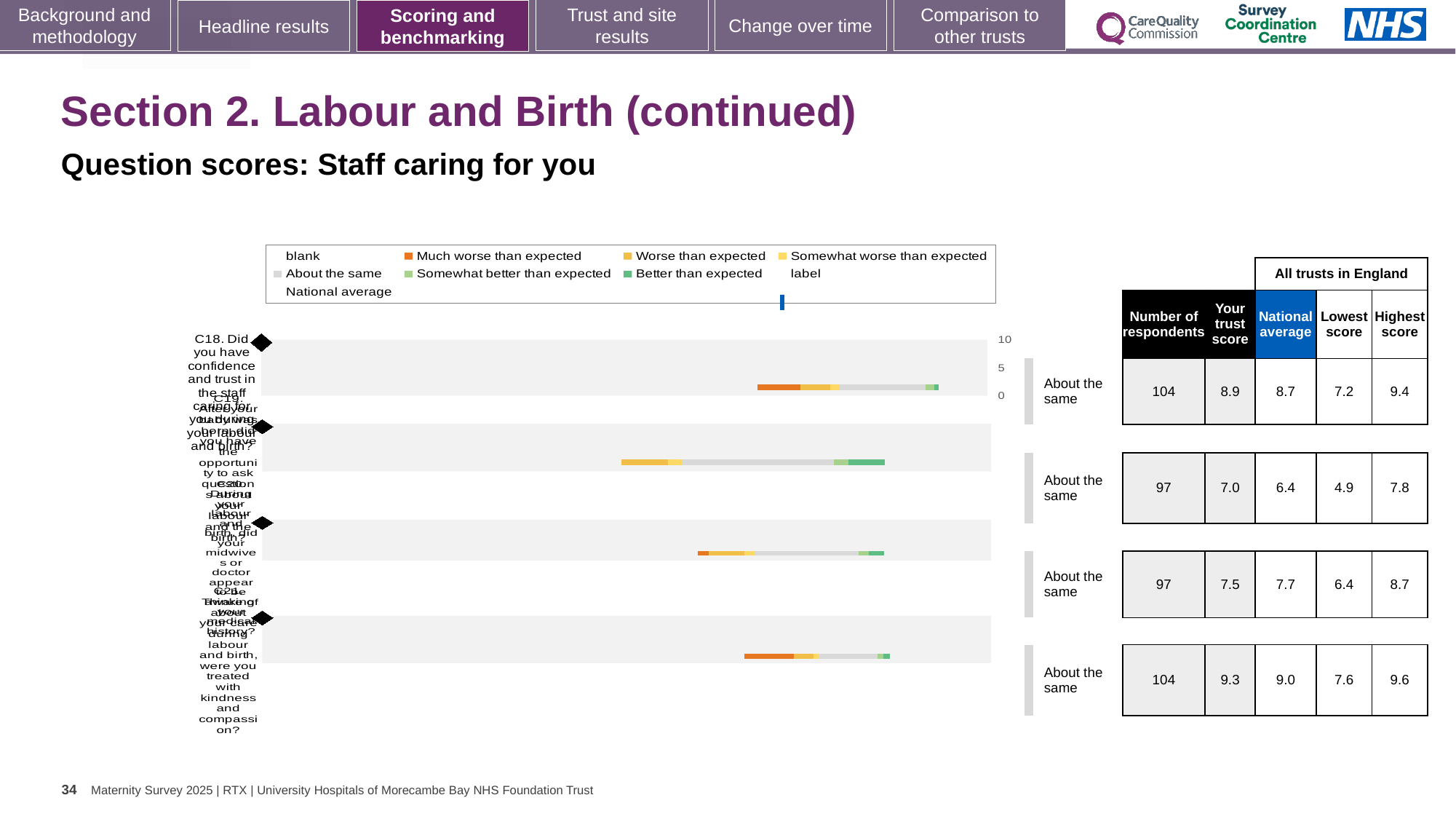
Which row in the table has the highest 'Your trust score'? the fourth row (9.3) In the table beside the chart, what is the number of respondents for the first row (C18)? 104 For the last row (C21), what is the difference between the trust score and the national average? 0.3 For the first row (C18), which is larger: the trust score or the national average? the trust score (8.9) In the table beside the chart, what is 'Your trust score' for the first row (C18)? 8.9 In the table beside the chart, what is the highest score for the last row (C21)? 9.6 What kind of chart is shown on the slide? bar chart Which row in the table has the lowest value in the 'Lowest score' column? the second row (4.9) In the table beside the chart, what is 'Your trust score' for the second row? 7.0 In the table beside the chart, what is the national average for the first row (C18)? 8.7 How many questions (rows) are plotted in the chart? 4 What comparison label is shown next to each of the four bars in the chart? About the same